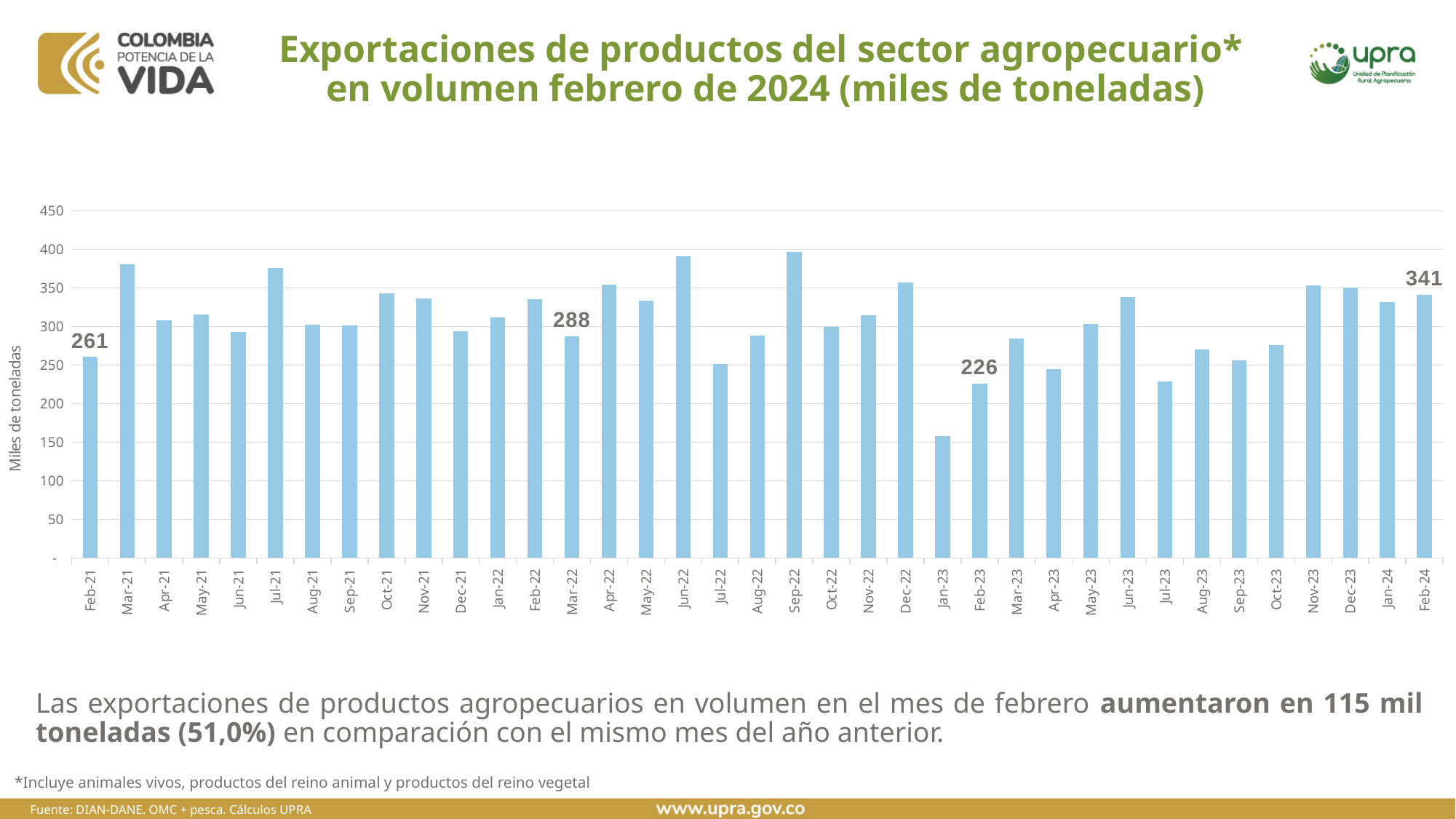
Which is larger, the value for Feb-21 or the value for Feb-23? Feb-21 What is the value for Feb-21? 261 Is the value for Mar-21 greater or less than 350? greater What kind of chart is shown on the slide? bar chart Is the value for Jul-23 greater or less than 250? less What is the value for Feb-24? 341 Is the value for Jan-23 greater or less than 200? less How many monthly bars are plotted in the chart? 37 Which month has the lowest value? Jan-23 What is the value for Feb-23? 226 What is the difference between the values for Feb-24 and Feb-21? 80 What is the difference between the values for Feb-24 and Feb-23? 115